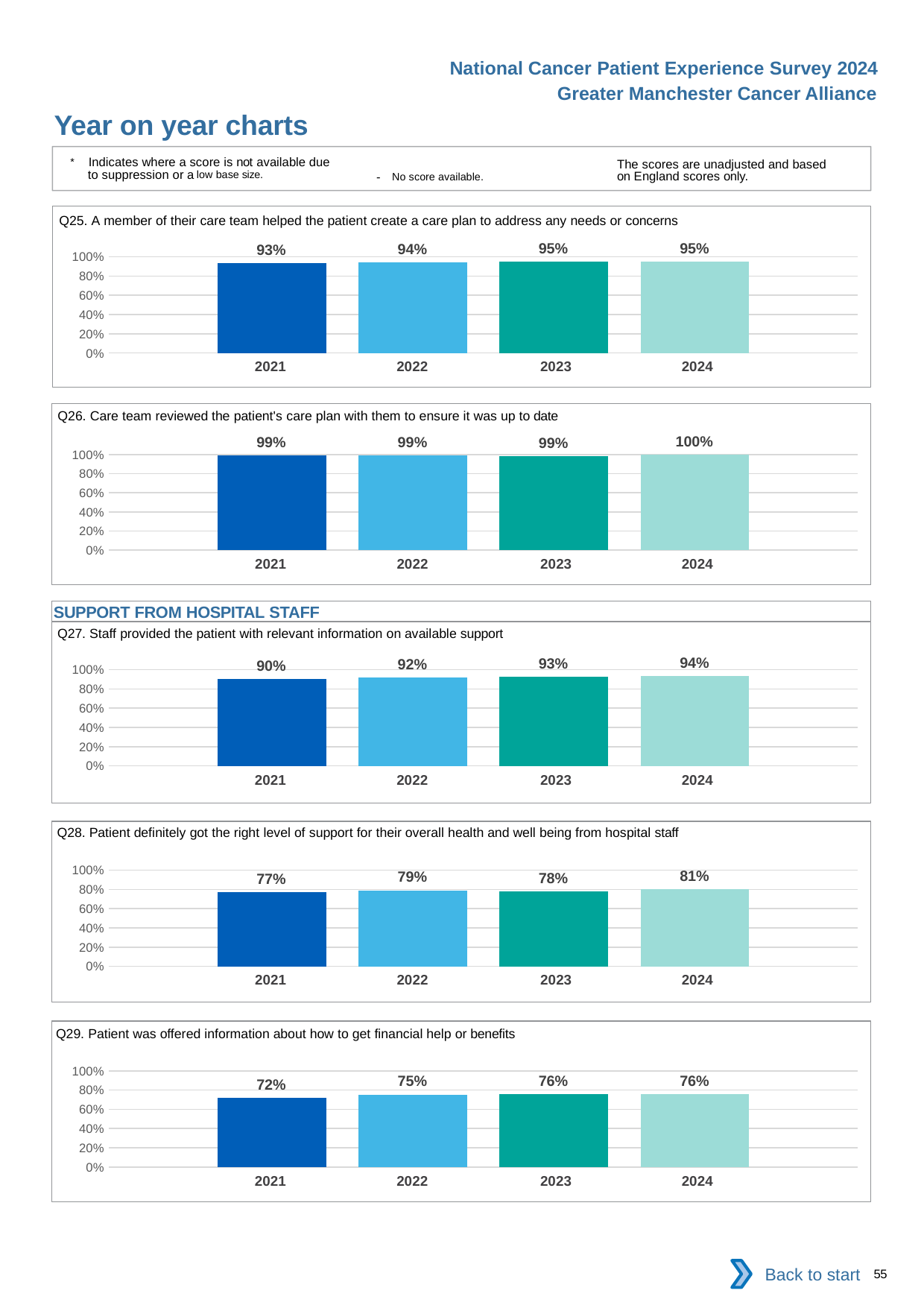
In the Q28 chart, which is larger, the value for 2022 or the value for 2023? 2022 In the Q29 chart, is the value for 2021 greater or less than 80%? less In the Q29 chart, what is the value for 2022? 75% In the Q27 chart, what is the difference between the 2024 and 2021 values? 4% In the Q28 chart, which year has the lowest value? 2021 In the Q26 chart, what is the value for 2023? 99% What is the section heading shown above the Q27 chart? SUPPORT FROM HOSPITAL STAFF In the Q27 chart, do the values rise or fall from 2021 to 2024? rise How many years are shown in the Q25 chart? 4 In the Q25 chart, what is the value for 2021? 93% What kind of chart is the Q27 chart? bar chart In the Q26 chart, which year has the highest value? 2024